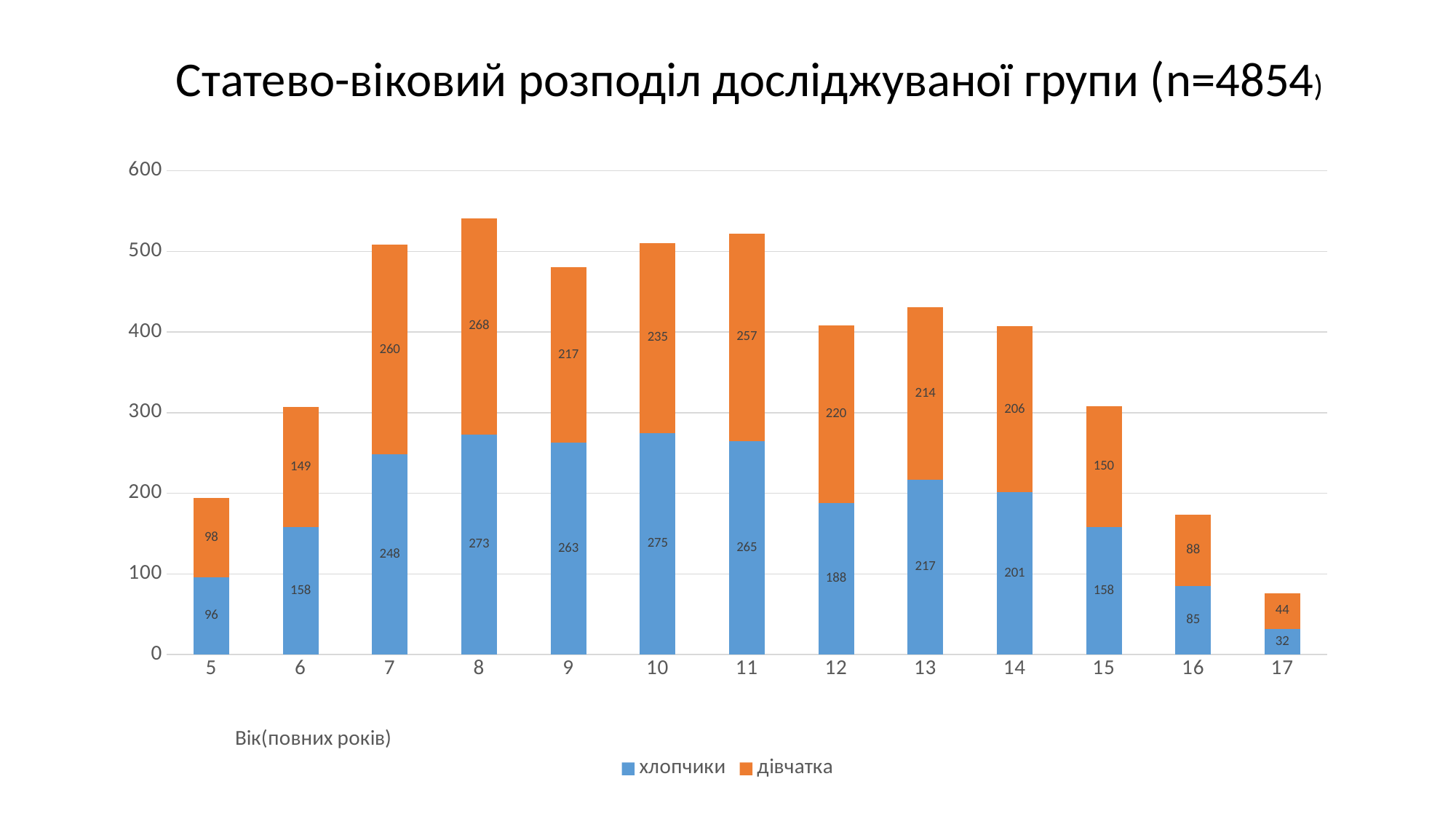
What is the difference between дівчатка and хлопчики at age 12? 32 Which age has the highest value for дівчатка? 8 Which is larger at age 9: хлопчики or дівчатка? хлопчики What is the value for дівчатка at age 7? 260 How many age categories are shown on the x axis? 13 What is the value for хлопчики at age 17? 32 What is the value for хлопчики at age 10? 275 What is the total of the stacked bar for age 8? 541 How many series does the legend list? 2 What kind of chart is shown on the slide? Stacked bar chart Which age has the lowest value for хлопчики? 17 What is the total of the stacked bar for age 5? 194